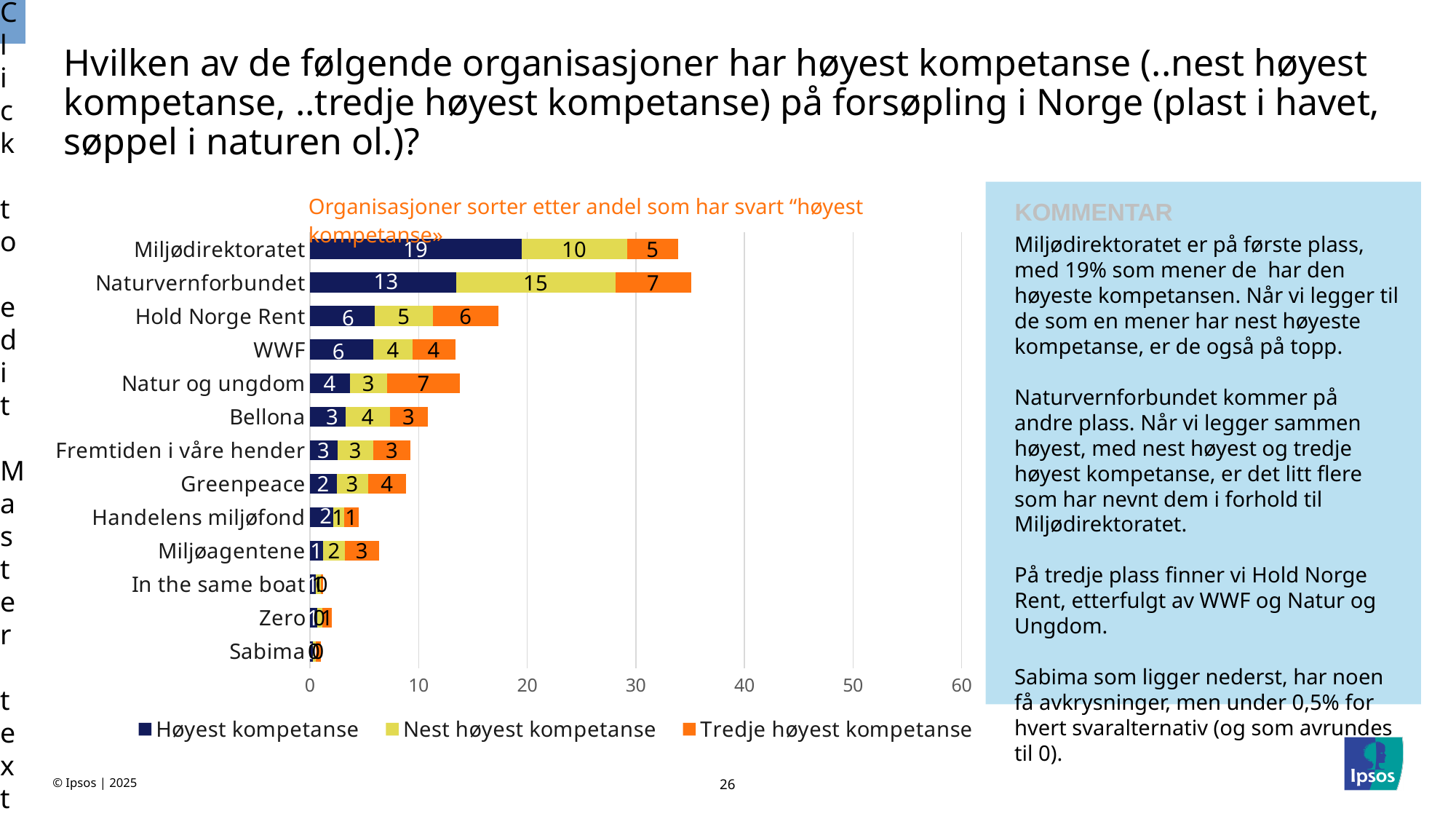
Which organisation has the highest value in the Nest høyest kompetanse series? Naturvernforbundet How many series does the legend list? 3 How many organisations are listed on the chart? 13 What is the difference between the Høyest kompetanse values for Miljødirektoratet and Naturvernforbundet? 6 What is the value for Naturvernforbundet in the Nest høyest kompetanse series? 15 Which organisation has the highest value in the Høyest kompetanse series? Miljødirektoratet What is the value for Natur og ungdom in the Tredje høyest kompetanse series? 7 What kind of chart is shown on the slide? Stacked bar chart What is the value for Miljødirektoratet in the Høyest kompetanse series? 19 What is the total of the stacked bar for Hold Norge Rent? 17 Which is larger: the Tredje høyest kompetanse value for Hold Norge Rent or for WWF? Hold Norge Rent What is the total of the stacked bar for Naturvernforbundet? 35